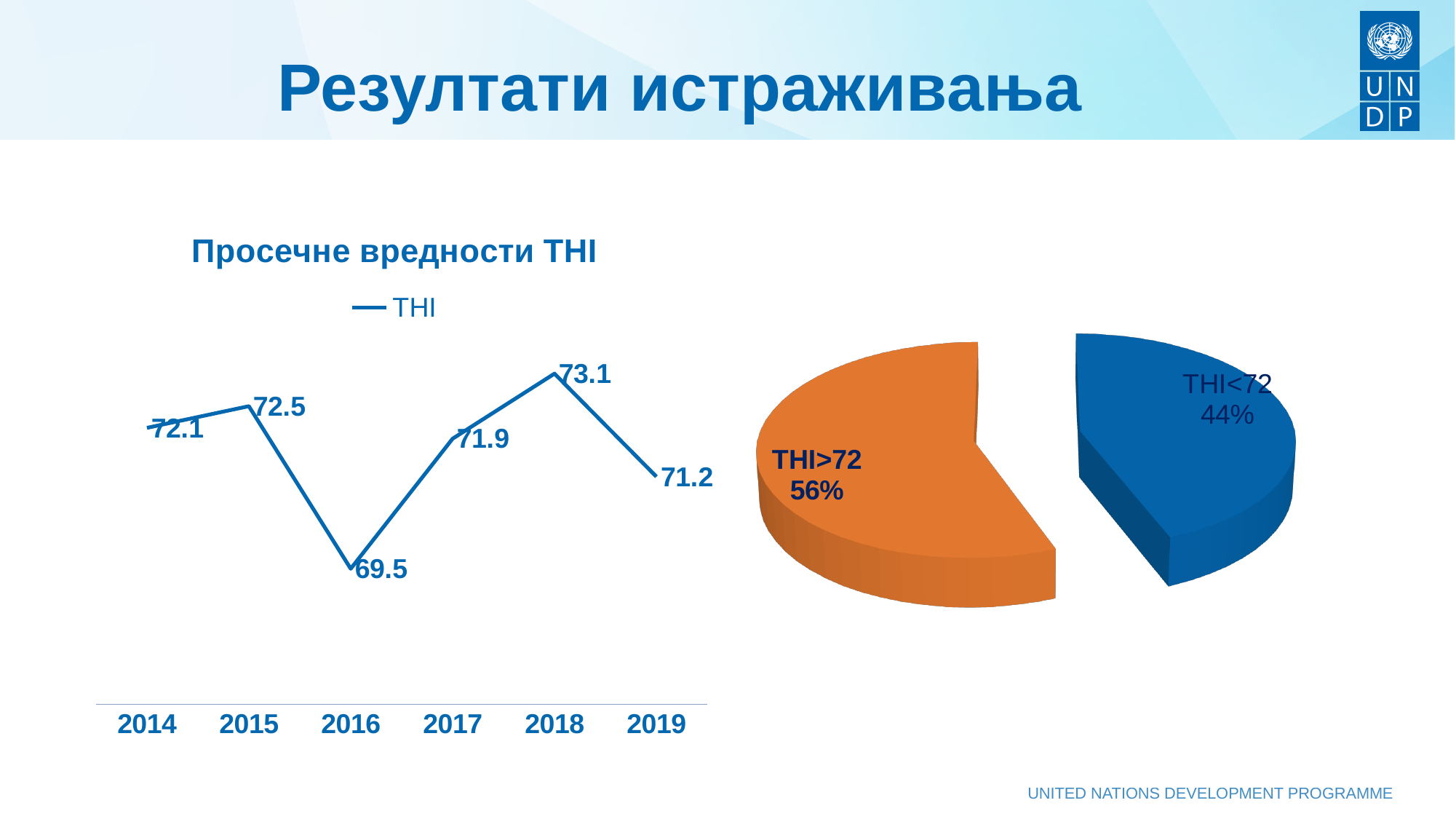
What type of chart is the chart on the right side of the slide? pie chart In the line chart 'Просечне вредности THI', what is the THI value for 2019? 71.2 In the line chart 'Просечне вредности THI', what is the difference between the THI values for 2018 and 2016? 3.6 In the line chart 'Просечне вредности THI', which year has a higher THI value, 2015 or 2017? 2015 In the line chart 'Просечне вредности THI', what is the THI value for 2018? 73.1 In the line chart 'Просечне вредности THI', which year has the highest THI value? 2018 In the pie chart on the right, what share does the 'THI>72' slice have? 56% In the line chart 'Просечне вредности THI', how many years are shown on the x axis? 6 In the line chart 'Просечне вредности THI', what is the THI value for 2016? 69.5 In the line chart 'Просечне вредности THI', which year has the lowest THI value? 2016 In the pie chart on the right, which slice is larger, 'THI>72' or 'THI<72'? THI>72 In the line chart 'Просечне вредности THI', does the THI value rise or fall from 2018 to 2019? fall